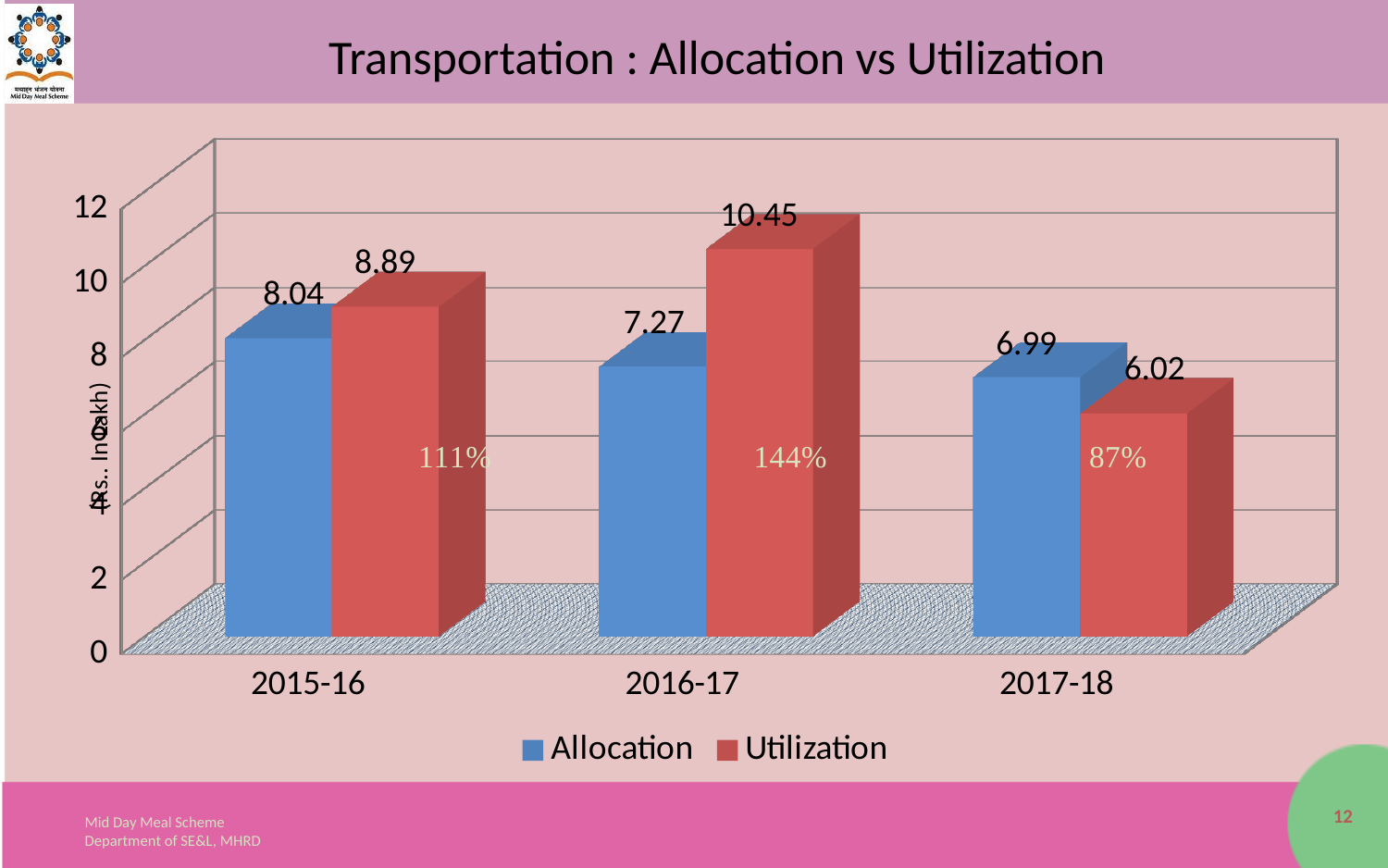
What is the Utilization value for 2017-18? 6.02 Which year has the highest Utilization value? 2016-17 What is the title of the chart? Transportation : Allocation vs Utilization How many series does the legend list? 2 Which year has the lowest Allocation value? 2017-18 What is the Allocation value for 2015-16? 8.04 Is the Utilization value for 2016-17 greater or less than 10? greater What is the Utilization value for 2016-17? 10.45 What is the difference between Utilization and Allocation in 2016-17? 3.18 In 2017-18, which is larger: Allocation or Utilization? Allocation How many years are shown on the x axis? 3 What kind of chart is shown on the slide? Bar chart